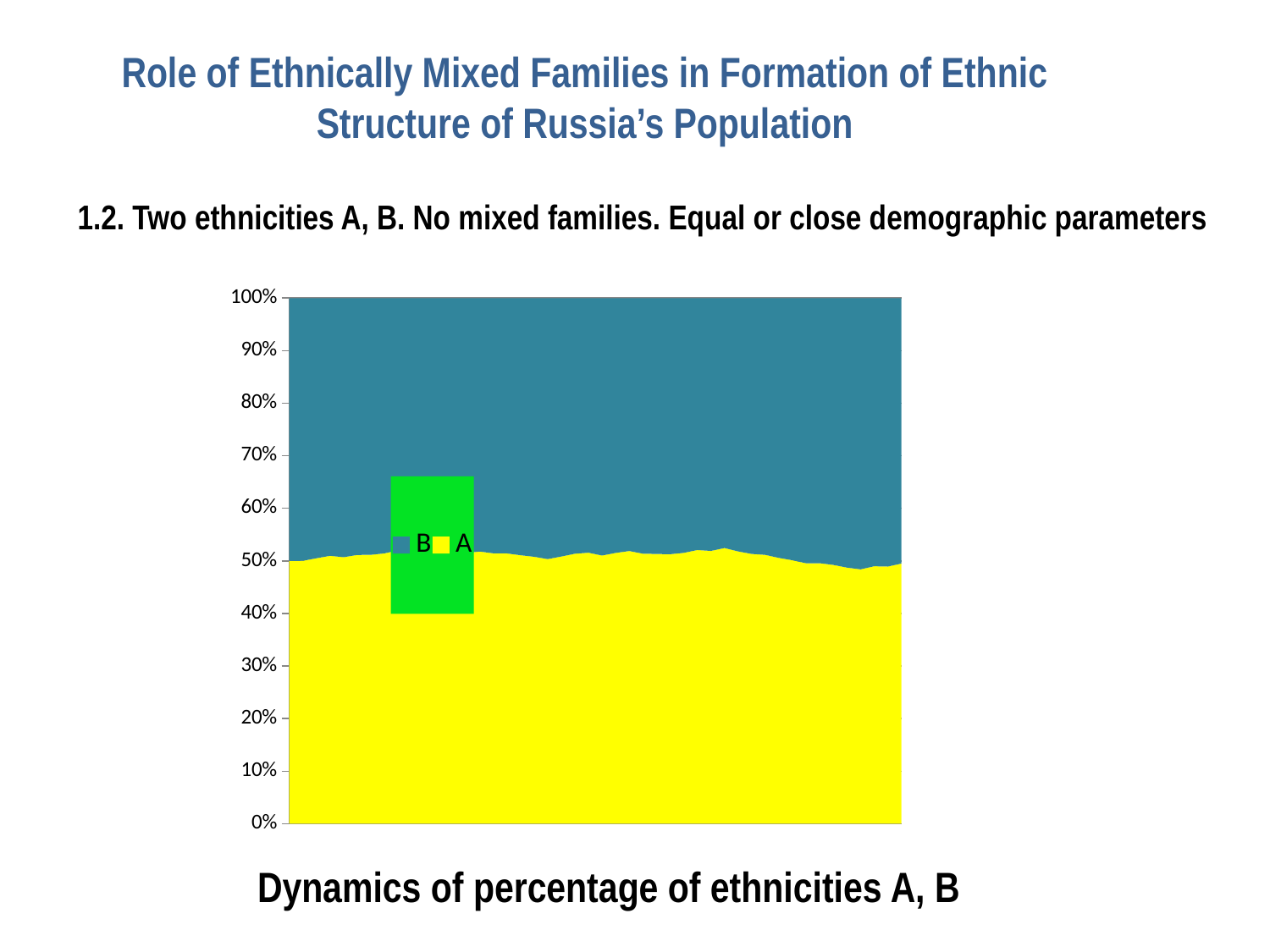
What is the highest value shown on the chart's vertical axis? 100% What kind of chart is shown on the slide? Area chart Which colour represents ethnicity A in the chart? Yellow Does the share of ethnicity A rise, fall, or stay roughly level across the chart? Stays roughly level Is the share of ethnicity A at the right edge of the chart greater or less than 70%? less How many series does the chart's legend list? 2 Is the share of ethnicity A at the left edge of the chart greater or less than 30%? greater Which series are listed in the chart's legend? B and A